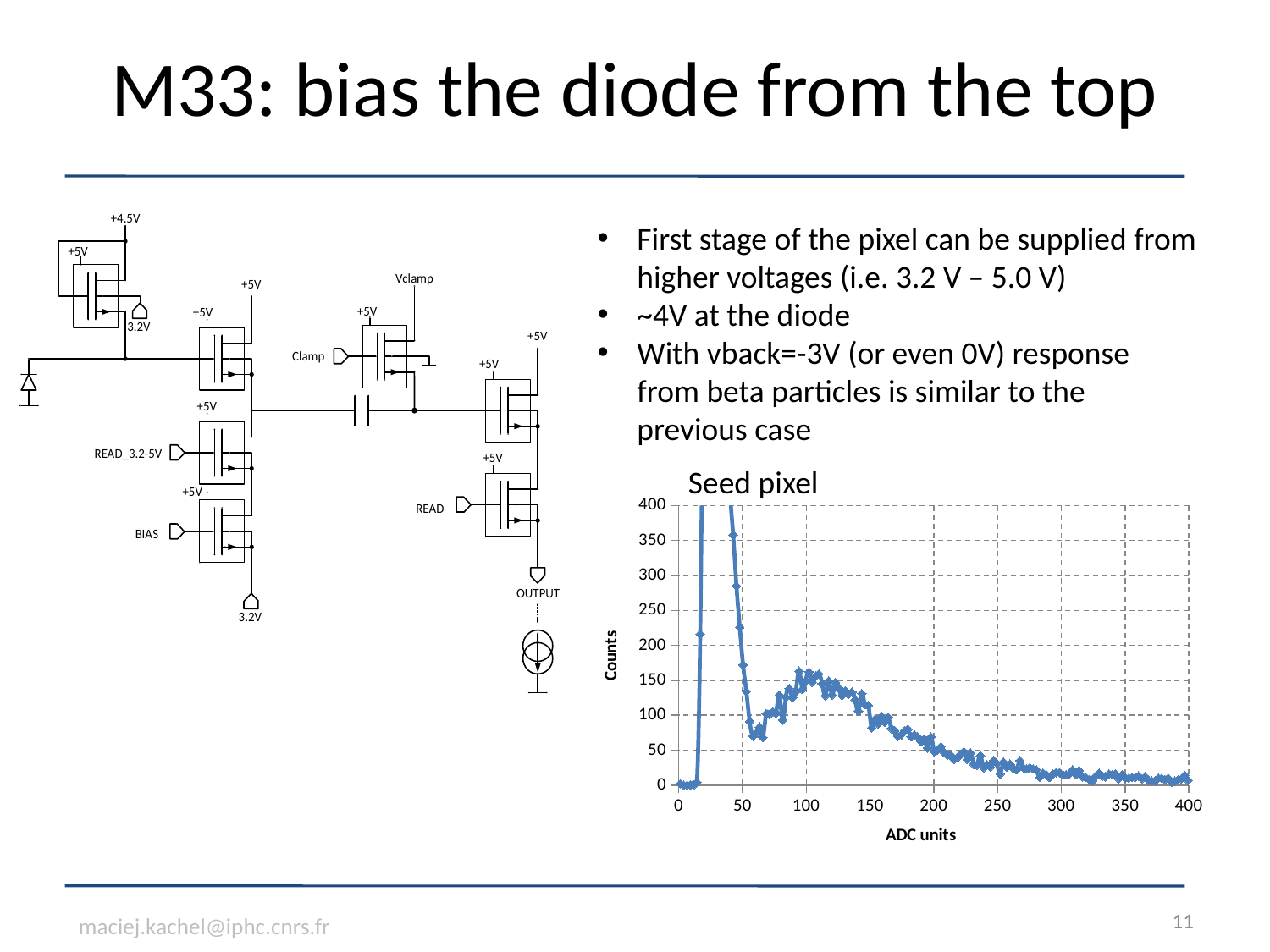
What is the title of the chart on the slide? Seed pixel What kind of chart is shown on the slide? line chart Which has the higher count, 100 ADC units or 300 ADC units? 100 ADC units Is the value for 300 ADC units greater or less than 50 counts? less Is the value for 250 ADC units greater or less than 100 counts? less Between 100 and 400 ADC units, do the counts generally rise or fall along the x axis? fall Which has the lower count, 200 ADC units or 400 ADC units? 400 ADC units Is the value for 400 ADC units greater or less than 50 counts? less What is the label of the x axis of the chart? ADC units